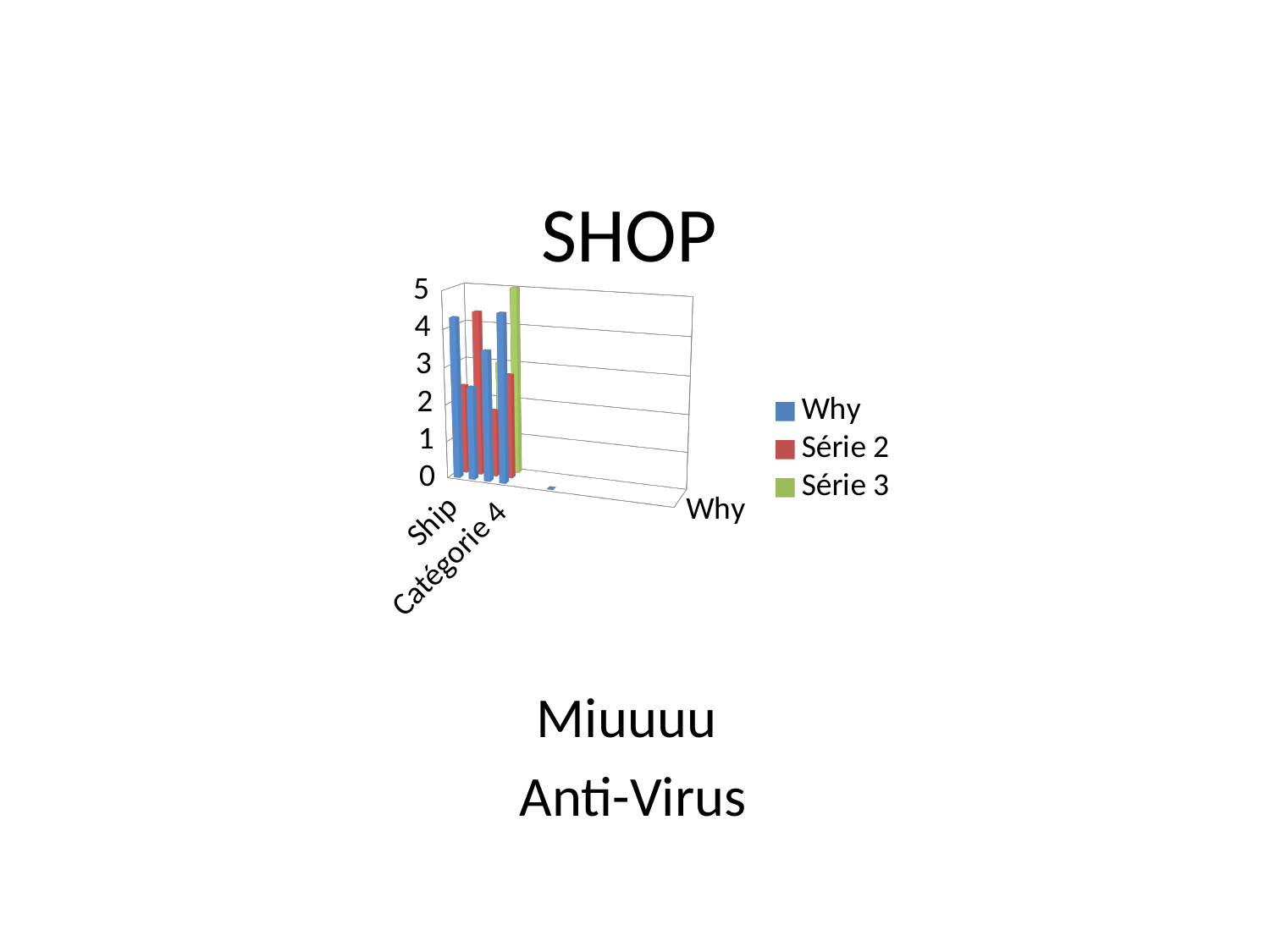
Which series is shown in green in the legend? Série 3 What is the title of the chart? SHOP What kind of chart is shown on the slide? bar chart What is the highest value shown on the vertical axis? 5 Is the value for the Why series in the Ship category greater or less than 2? greater How many series does the legend list? 3